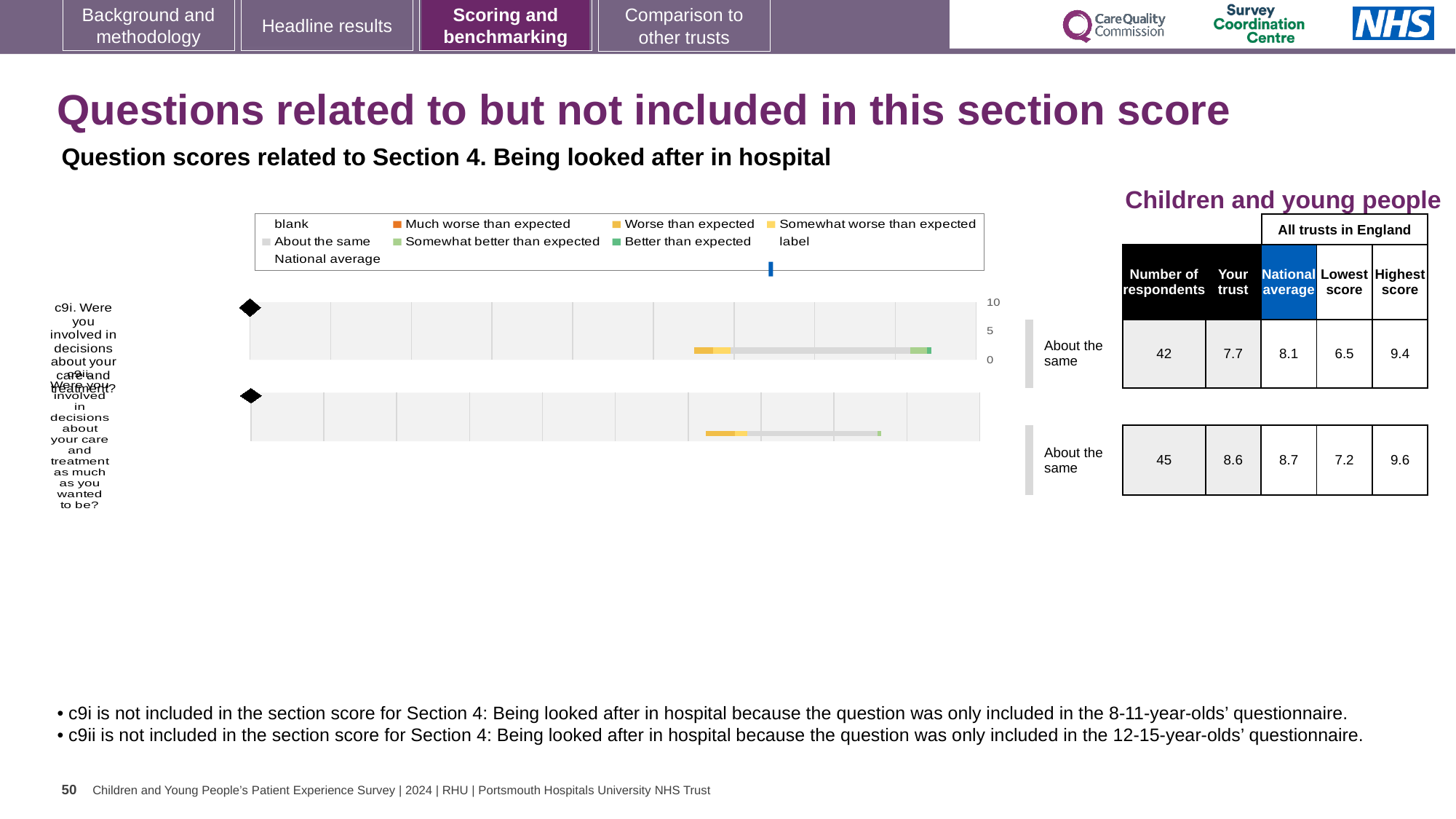
What is the national average score for c9ii? 8.7 Is the trust's score for c9ii greater or less than 5 on the chart axis? greater Which legend entry is represented by the blue marker? National average Which question has the higher 'Highest score' across all trusts in England? c9ii What benchmark category is shown next to the bar for c9i? About the same How many respondents answered c9ii? 45 By how much does the national average exceed the trust's score for c9i? 0.4 Which question has the higher 'Your trust' score, c9i or c9ii? c9ii What is the 'Your trust' score for c9i (Were you involved in decisions about your care and treatment?)? 7.7 What kind of chart is used to show the question scores for c9i and c9ii? bar chart What is the difference between the highest score and the lowest score across all trusts for c9i? 2.9 How many questions (bars) are plotted in the chart? 2